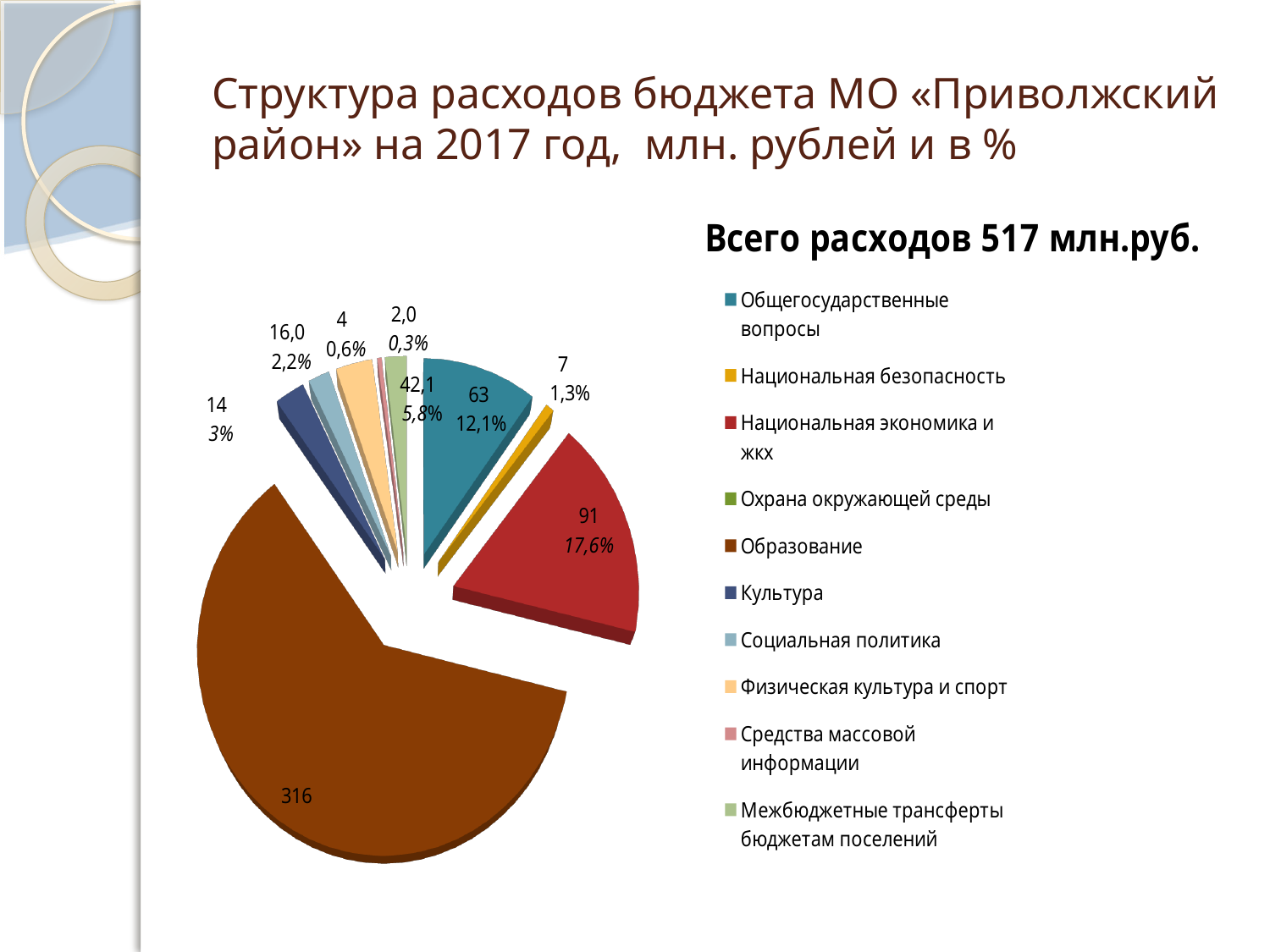
What share of the pie is Культура? 3% What is the title of the chart? Всего расходов 517 млн.руб. What is the difference between the values for Национальная экономика и ЖКХ and Общегосударственные вопросы? 28 How many categories does the chart legend list? 10 What kind of chart is shown on the slide? pie chart What value in million rubles is shown for Национальная безопасность? 7 Which category has the largest slice of the pie? Образование What share of the pie is Общегосударственные вопросы? 12,1% What value is shown for Образование? 316 What share of the pie is Национальная экономика и ЖКХ? 17,6% What value in million rubles is shown for Национальная экономика и ЖКХ? 91